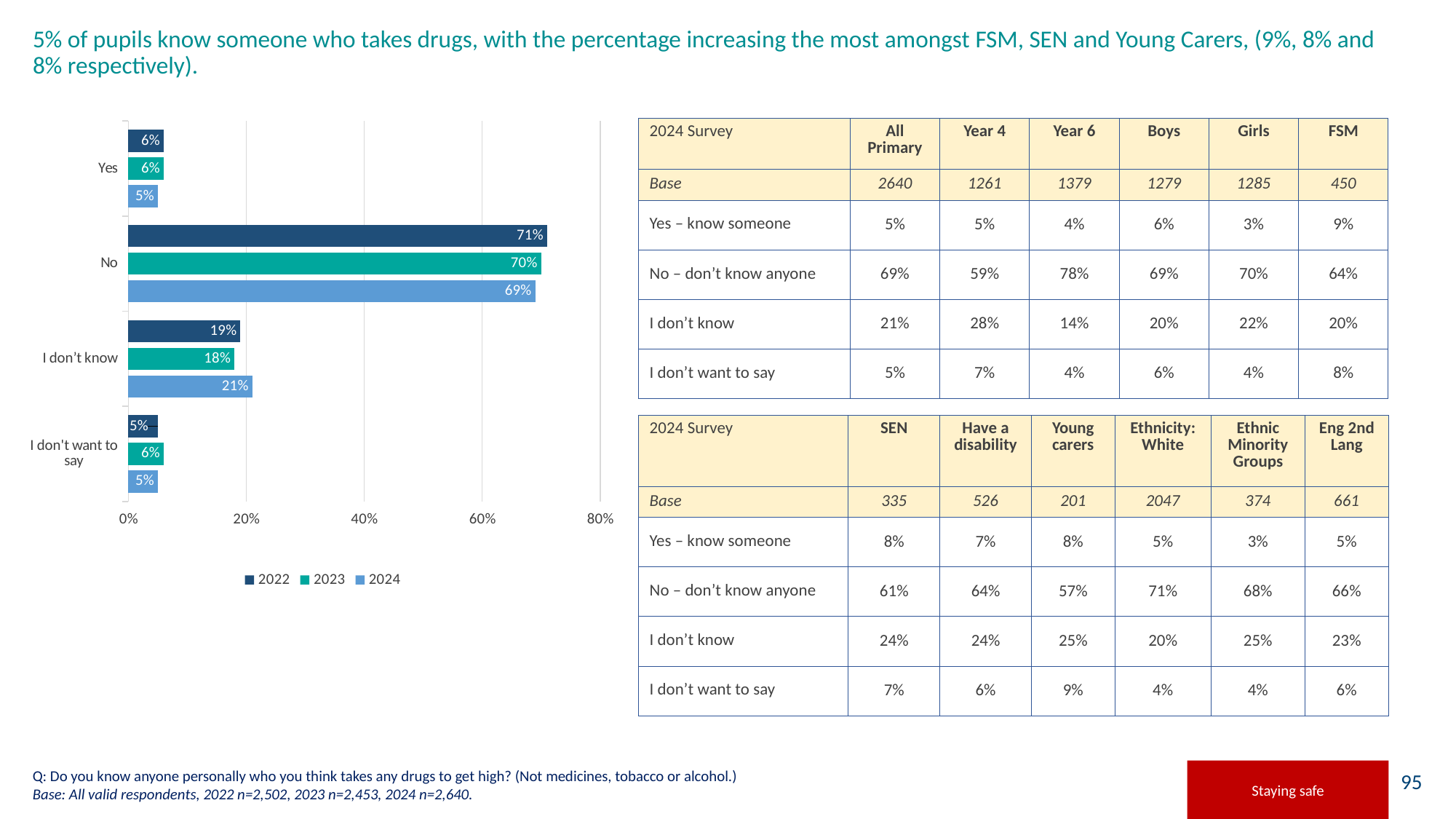
Which is larger for 'I don't know': the 2022 value or the 2024 value? 2024 How many series does the chart legend list? 3 Does the value for 'No' rise or fall from 2022 to 2024? fall How many response categories are shown on the chart? 4 What is the difference between the 2024 and 2023 values for 'I don't know'? 3% What is the difference between the 2022 and 2024 values for 'No'? 2% What kind of chart is shown on the slide? bar chart What is the 2023 value for 'Yes'? 6% Which response category has the highest value in 2024? No Which series is shown in the darkest blue colour in the legend? 2022 What is the 2022 value for 'I don't know'? 19% What is the 2024 value for 'No'? 69%